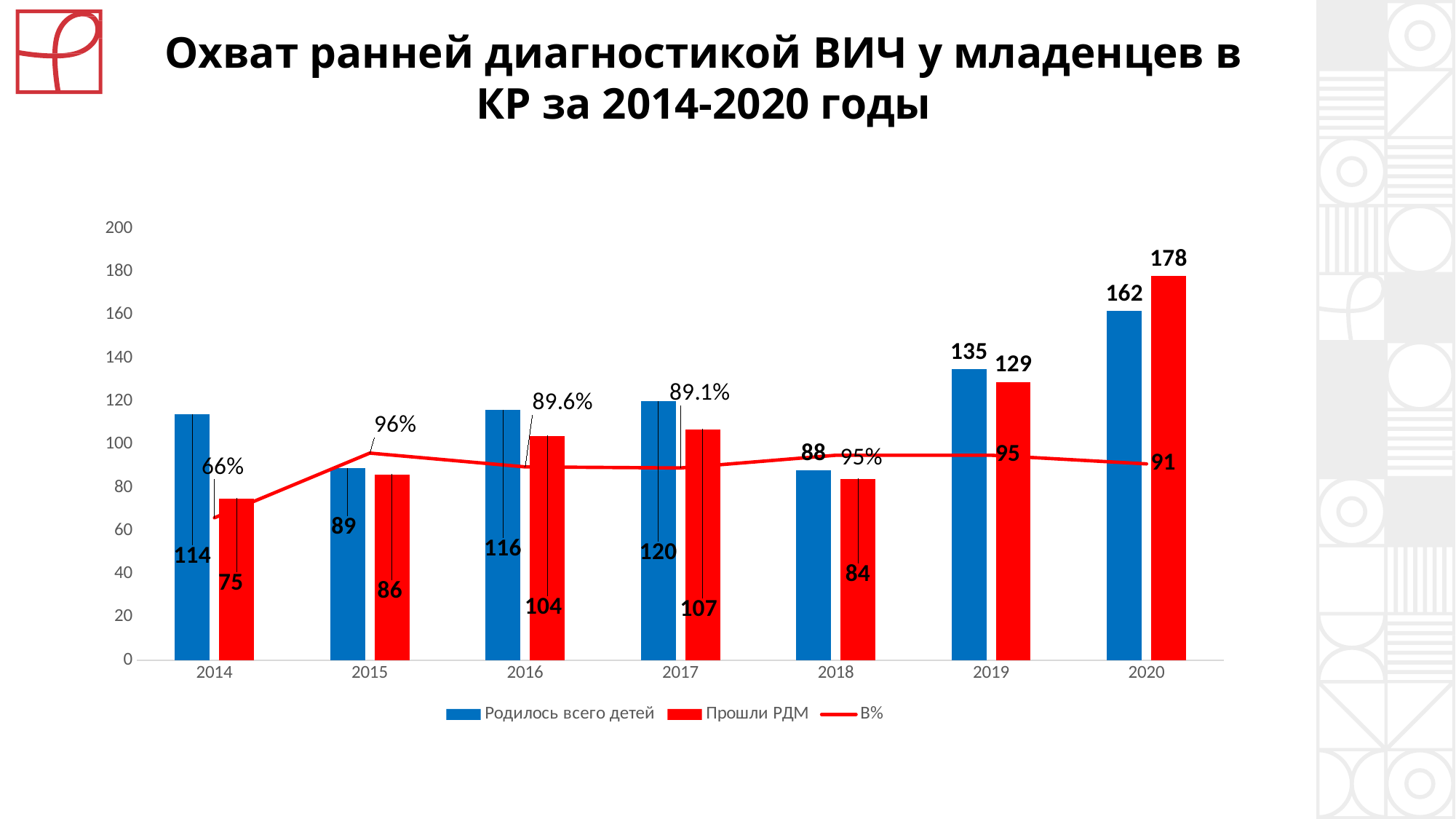
What is the В% value shown for 2015? 96% How many years are shown on the x axis? 7 What is the В% value shown for 2016? 89.6% What is the label of the series drawn as a red line? В% Which year has the highest value for Родилось всего детей? 2020 What is the value of Прошли РДМ for 2020? 178 What is the difference between Родилось всего детей and Прошли РДМ in 2014? 39 What kind of chart is shown on the slide? Bar chart with a line Which is larger in 2020: Родилось всего детей or Прошли РДМ? Прошли РДМ What is the value of Родилось всего детей for 2014? 114 Which year has the lowest value for Прошли РДМ? 2014 How many series does the legend list? 3